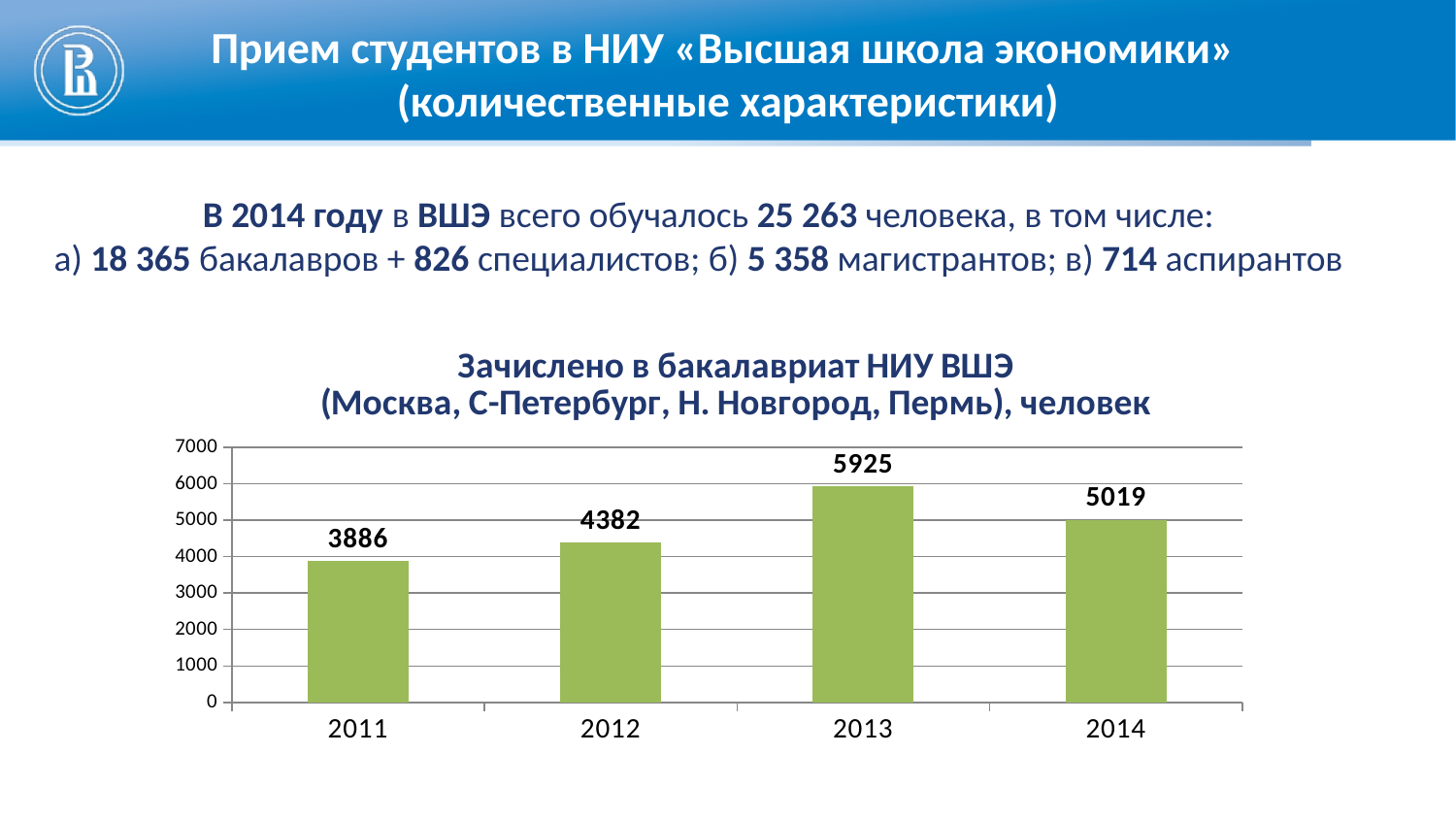
Which is larger, the value for 2012 or the value for 2014? 2014 Which year has the lowest value? 2011 What is the value for 2011? 3886 What is the difference between the values for 2012 and 2011? 496 Which year has the highest value? 2013 What kind of chart is shown on the slide? bar chart What is the value for 2013? 5925 What is the title of the chart? Зачислено в бакалавриат НИУ ВШЭ (Москва, С-Петербург, Н. Новгород, Пермь), человек What is the difference between the values for 2013 and 2014? 906 What is the value for 2014? 5019 How many years are shown on the x axis? 4 Is the value for 2013 greater or less than 5000? greater